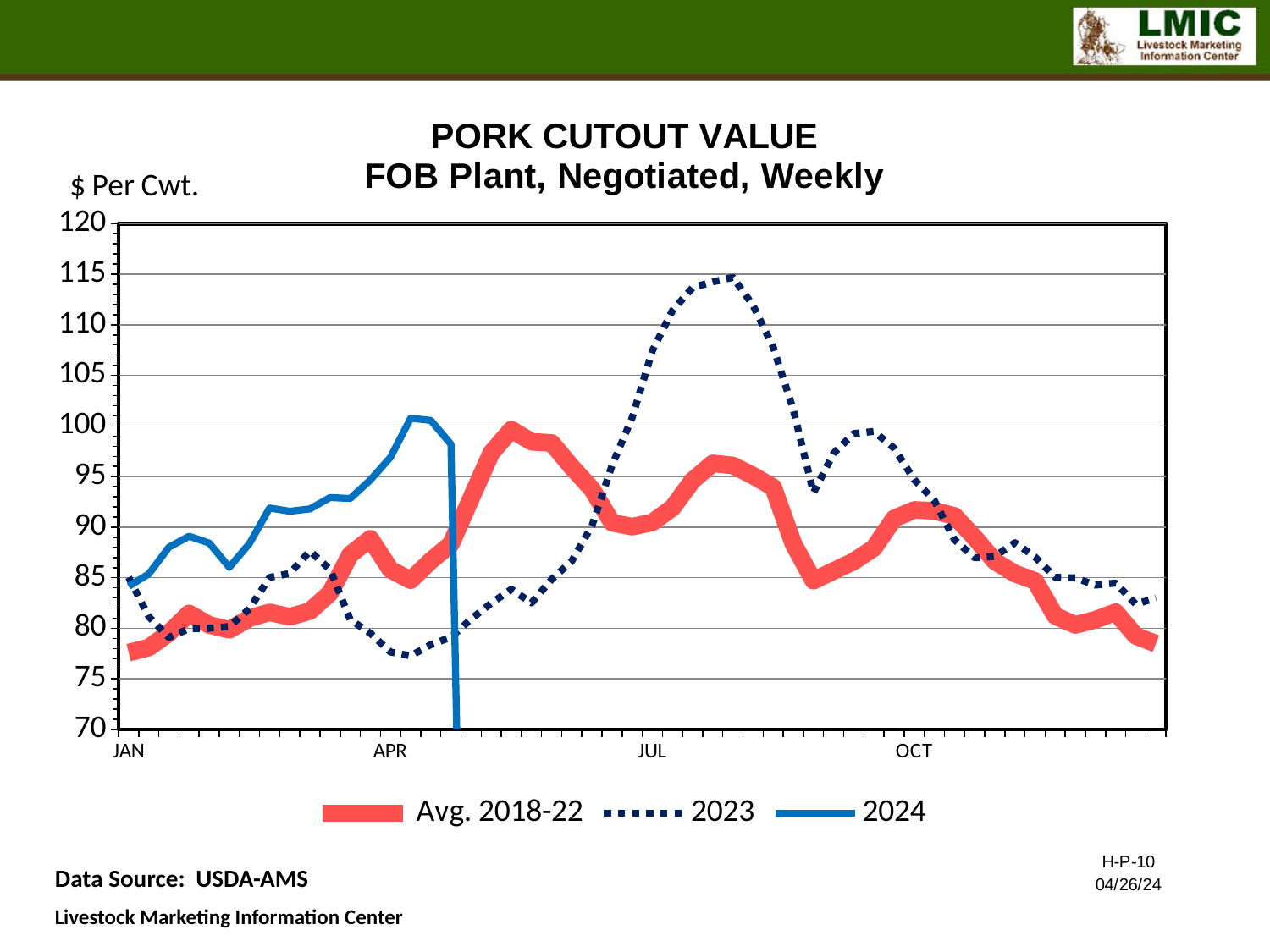
What is the title of the chart? PORK CUTOUT VALUE FOB Plant, Negotiated, Weekly How many series does the legend list? 3 Is the value of the Avg. 2018-22 series at JAN greater or less than 80? less What kind of chart is shown on the slide? line chart What unit is shown on the y axis of the chart? $ Per Cwt. How many month labels are shown on the x axis? 4 Is the peak value of the 2023 series greater or less than 110? greater Is the value of the 2024 series at JAN greater or less than 80? greater Does the 2024 series rise or fall from JAN to the start of APR? rise Which series reaches the highest value on the chart? 2023 At JAN, which series has the higher value, 2024 or Avg. 2018-22? 2024